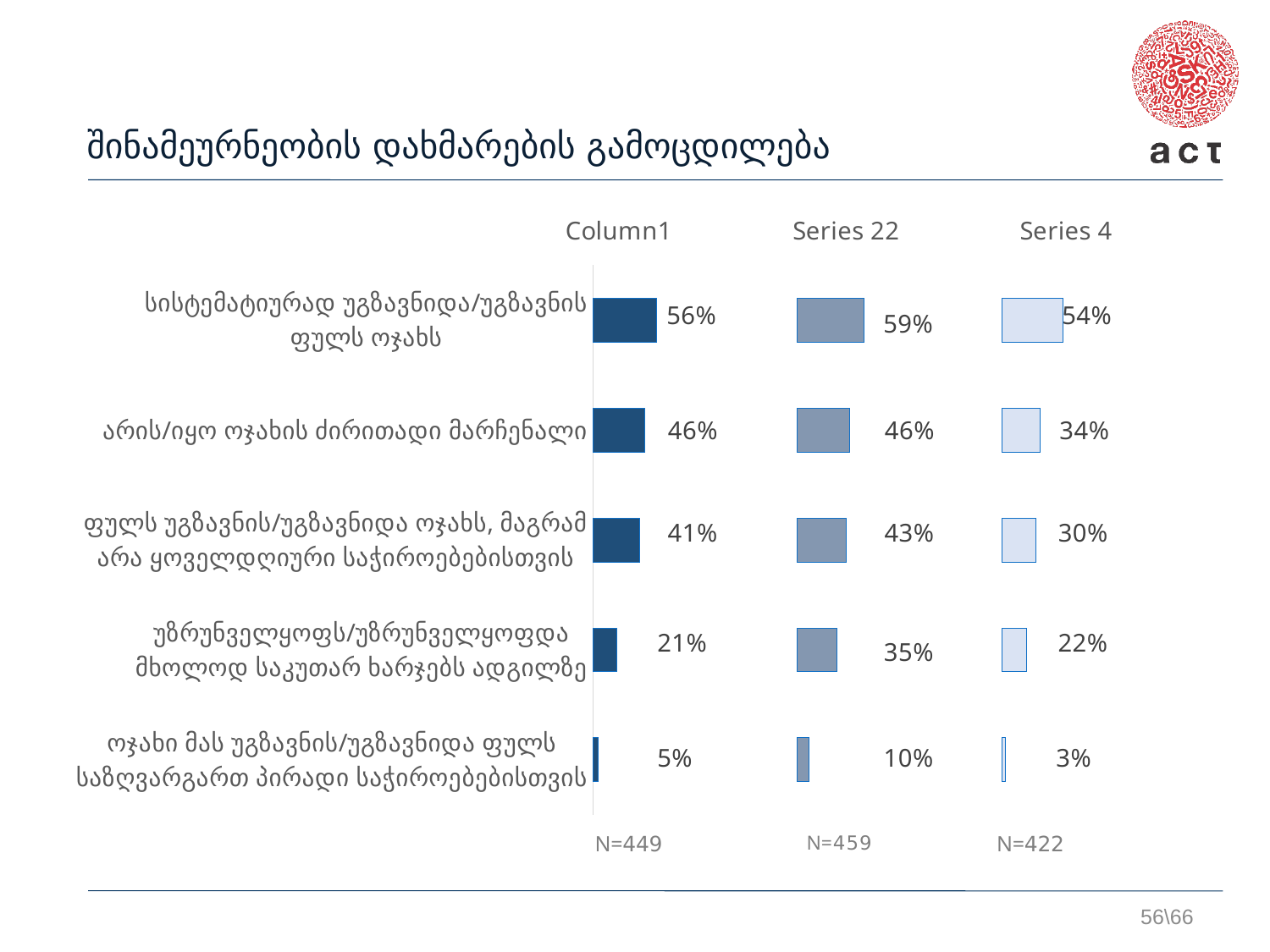
What is the difference between the Series 22 and Series 4 values for "არის/იყო ოჯახის ძირითადი მარჩენალი"? 12 percentage points In the Series 22 chart, which category has the highest value? სისტემატიურად უგზავნიდა/უგზავნის ფულს ოჯახს What type of chart is used on this slide? Bar chart How many categories are shown in the Column1 chart? 5 In the Series 22 chart, what is the value for "უზრუნველყოფს/უზრუნველყოფდა მხოლოდ საკუთარ ხარჯებს ადგილზე"? 35% In the Series 4 chart, what is the value for "სისტემატიურად უგზავნიდა/უგზავნის ფულს ოჯახს"? 54% What is the sample size (N) shown under the Series 4 chart? N=422 In the Column1 chart, what is the value for "არის/იყო ოჯახის ძირითადი მარჩენალი"? 46% For "უზრუნველყოფს/უზრუნველყოფდა მხოლოდ საკუთარ ხარჯებს ადგილზე", which is larger: the Column1 value or the Series 22 value? Series 22 In the Series 4 chart, which category has the lowest value? ოჯახი მას უგზავნის/უგზავნიდა ფულს საზღვარგართ პირადი საჭიროებებისთვის In the Column1 chart, what is the difference between the top category (56%) and the bottom category (5%)? 51 percentage points What is the title of the slide? შინამეურნეობის დახმარების გამოცდილება